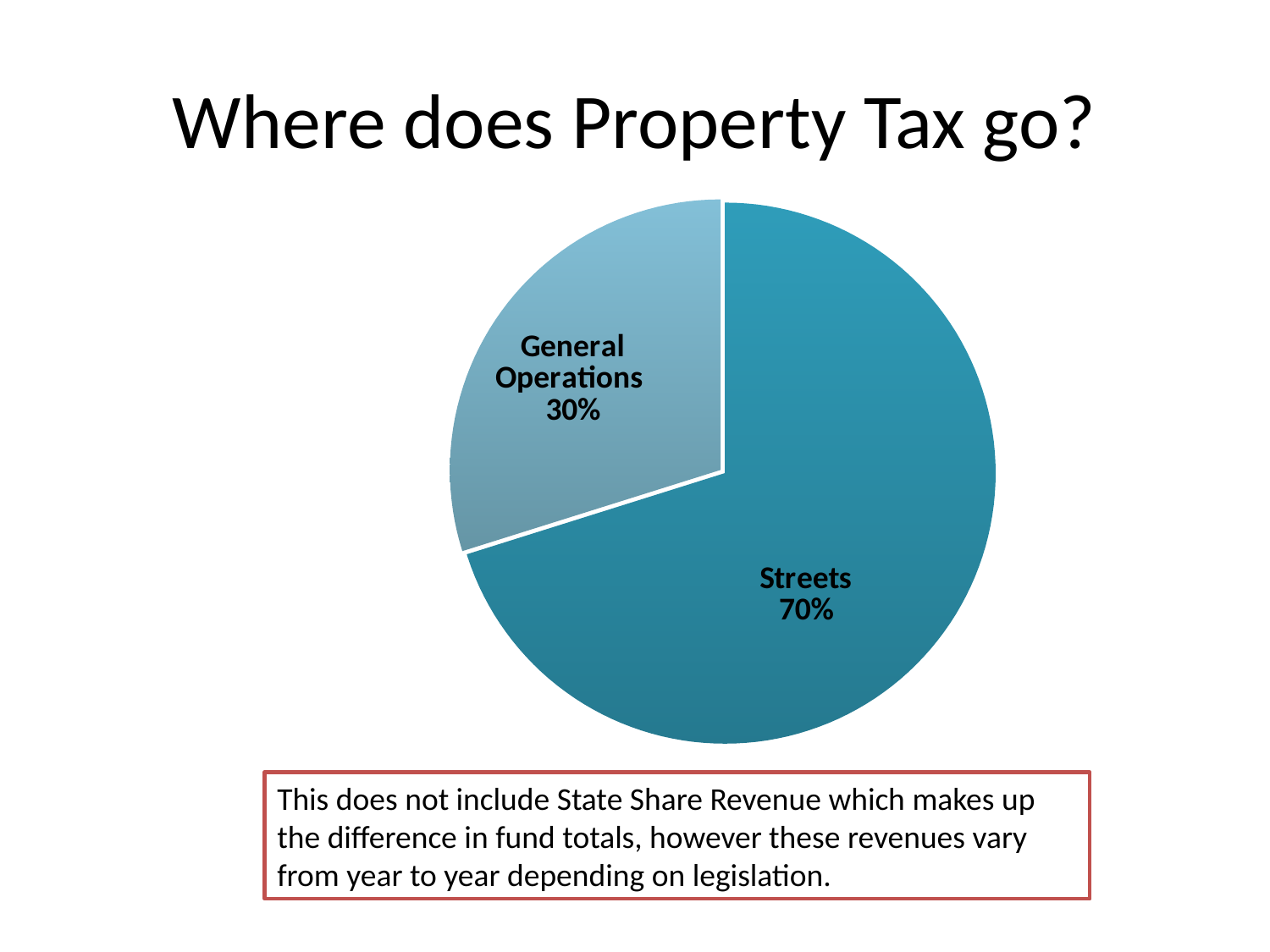
Which is larger, the Streets slice or the General Operations slice? Streets What share of property tax goes to Streets? 70% What is the difference in percentage points between the Streets and General Operations slices? 40 What kind of chart is shown on the slide? pie chart What is the title of the slide containing the pie chart? Where does Property Tax go? What share of property tax goes to General Operations? 30% How many slices does the pie chart have? 2 Which slice of the pie is the largest? Streets Which slice is shown in the lighter shade of blue? General Operations Which slice of the pie is the smallest? General Operations Is the share for General Operations greater or less than 50%? less